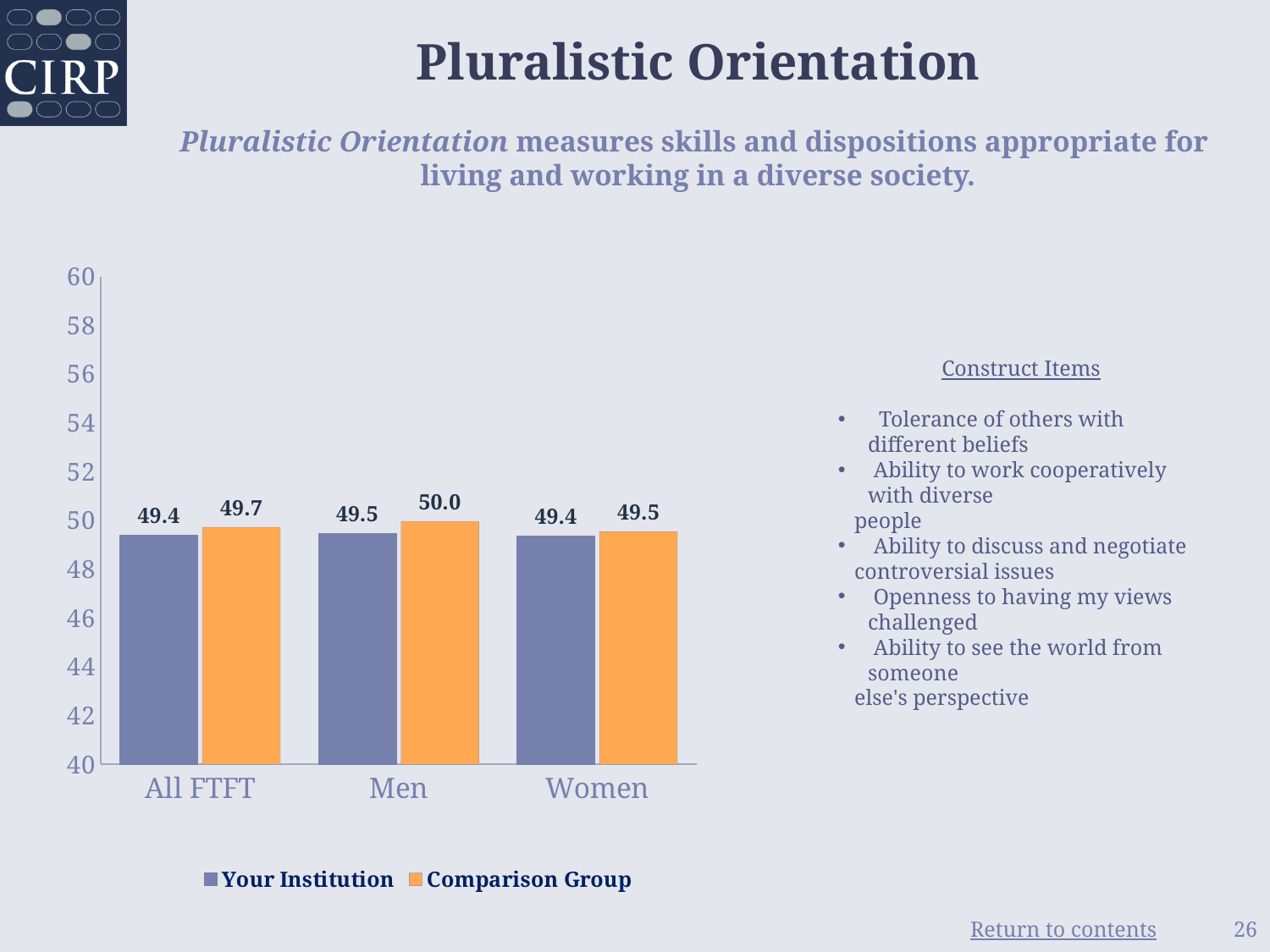
What kind of chart is shown on the slide? Bar chart Which colour represents the Comparison Group series? Orange How many categories are shown on the x axis? 3 What is the Comparison Group value for Women? 49.5 How many series does the legend list? 2 What is the difference between the Comparison Group and Your Institution values for All FTFT? 0.3 What is the Your Institution value for All FTFT? 49.4 What is the Comparison Group value for All FTFT? 49.7 Which category has the highest Comparison Group value? Men What is the difference between the Comparison Group and Your Institution values for Men? 0.5 For Women, which is larger: Your Institution or Comparison Group? Comparison Group What is the Your Institution value for Men? 49.5